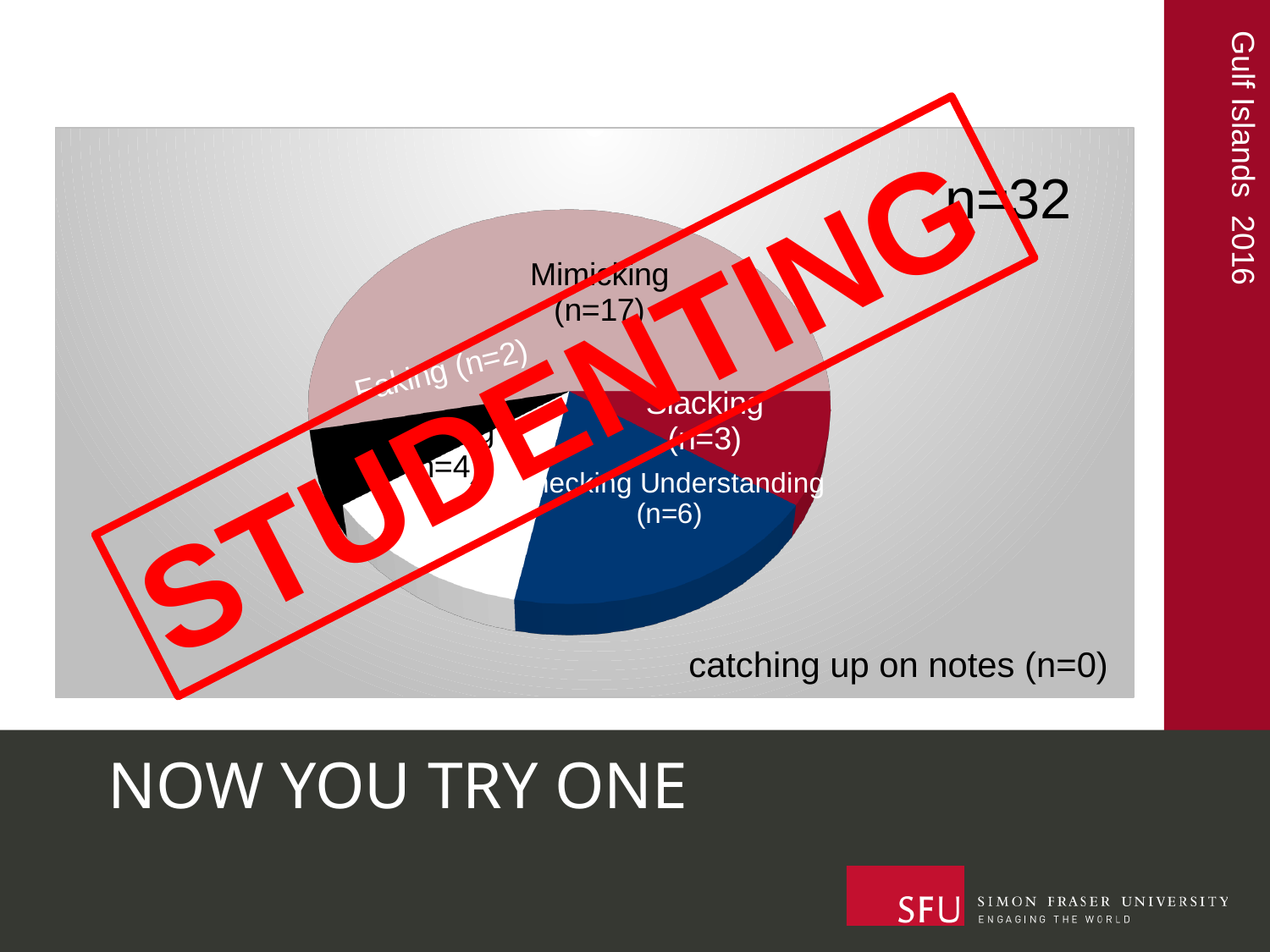
What kind of chart is shown on the slide? pie chart Which is larger, the Mimicking slice or the Checking Understanding slice? Mimicking Which category has the largest slice of the pie? Mimicking What total n is shown in the top right of the chart? n=32 What word is stamped in red across the chart? STUDENTING How many more responses does Mimicking have than Checking Understanding? 11 What is the n value for the 'catching up on notes' category? n=0 Which category has the smallest value in the chart? catching up on notes What is the n value for the Mimicking slice? n=17 What is the n value for the Slacking slice? n=3 What is the n value for the Checking Understanding slice? n=6